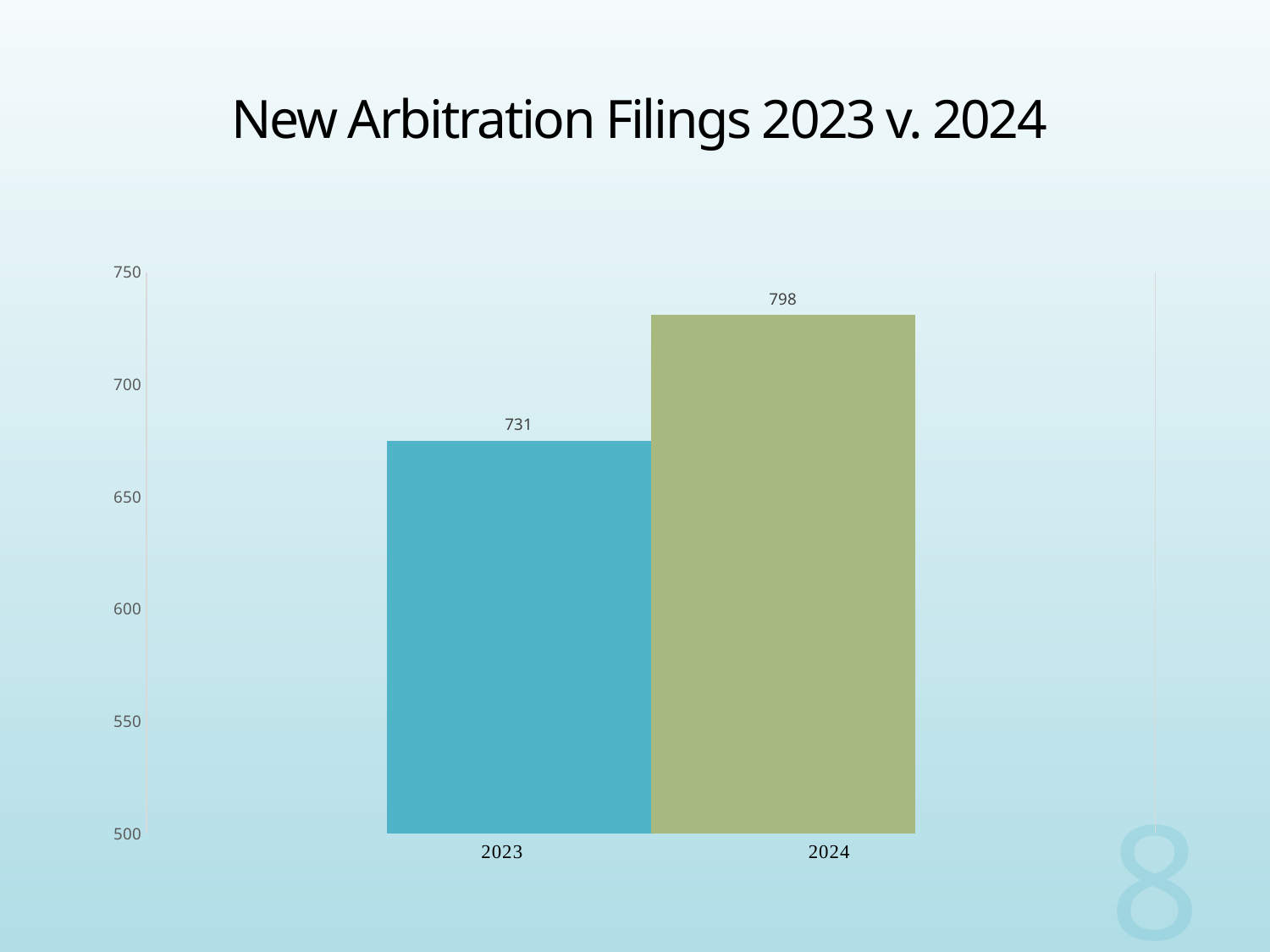
Which is larger, the value for 2023 or the value for 2024? 2024 Is the value for 2023 greater or less than 650? greater What is the value for 2023? 731 What kind of chart is shown on the slide? bar chart What is the title of the chart? New Arbitration Filings 2023 v. 2024 Which year has the lowest number of new arbitration filings? 2023 How many categories are shown on the x axis? 2 What is the value for 2024? 798 Which year has the highest number of new arbitration filings? 2024 Is the value for 2024 greater or less than 700? greater What is the difference between the 2024 and 2023 values? 67 Do the values rise or fall from 2023 to 2024? rise